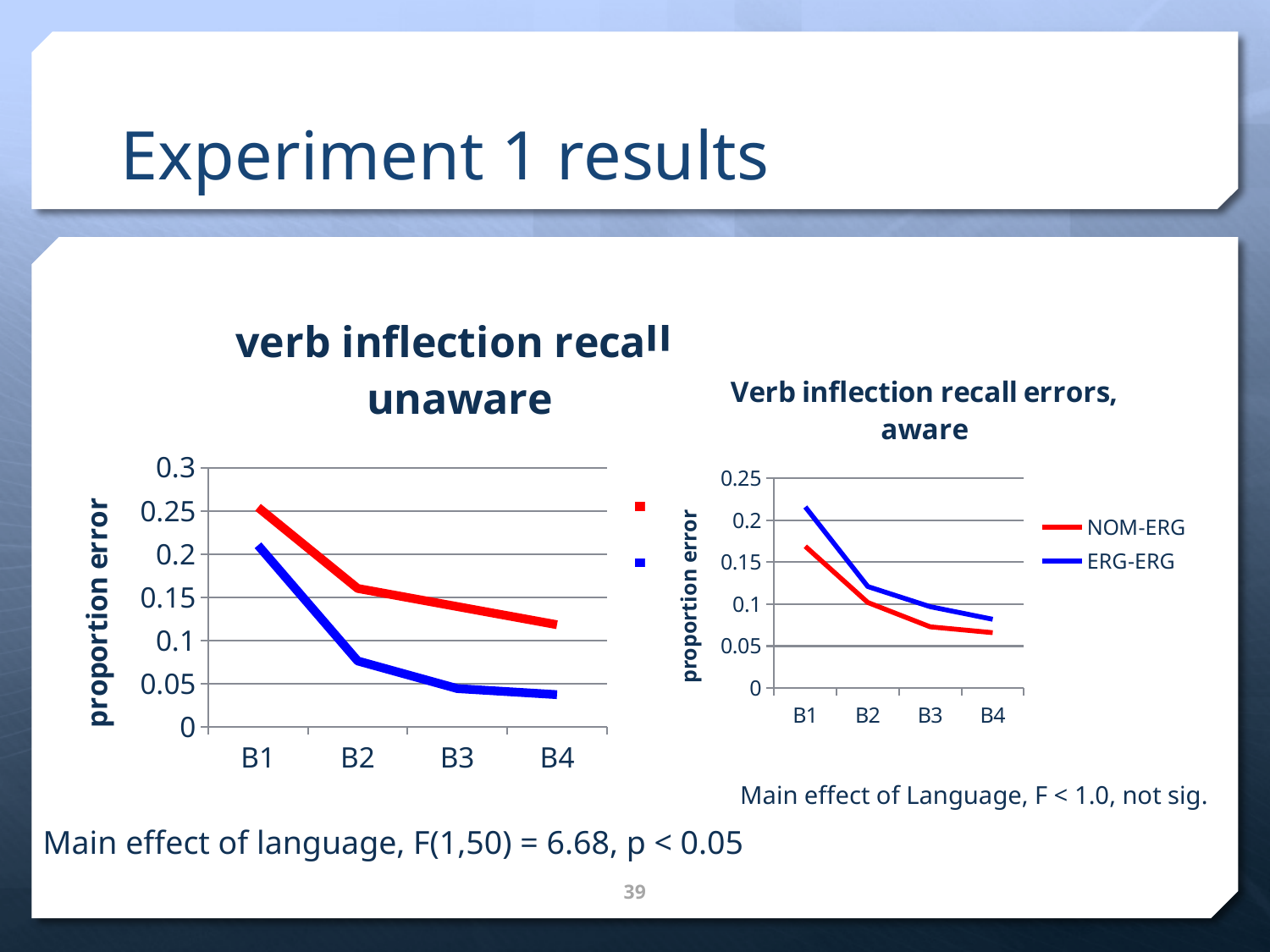
In the 'Verb inflection recall errors, aware' chart, at which block is the ERG-ERG value highest? B1 In the 'verb inflection recall unaware' chart, is the blue line's value at B4 greater or less than 0.05? less What kind of chart is the 'verb inflection recall unaware' chart on the left? line chart In the 'Verb inflection recall errors, aware' chart, is the NOM-ERG value at B4 greater or less than 0.1? less In the 'verb inflection recall unaware' chart, is the red line's value at B1 greater or less than 0.2? greater In the 'Verb inflection recall errors, aware' chart, do the NOM-ERG values rise or fall from B1 to B4? fall How many series does the legend of the 'Verb inflection recall errors, aware' chart list? 2 What is the y-axis title of the 'verb inflection recall unaware' chart? proportion error In the 'Verb inflection recall errors, aware' chart, which series has the larger value at B1, NOM-ERG or ERG-ERG? ERG-ERG How many categories are shown on the x axis of the 'Verb inflection recall errors, aware' chart? 4 In the 'verb inflection recall unaware' chart, which line has the larger value at B2, the red line or the blue line? red line